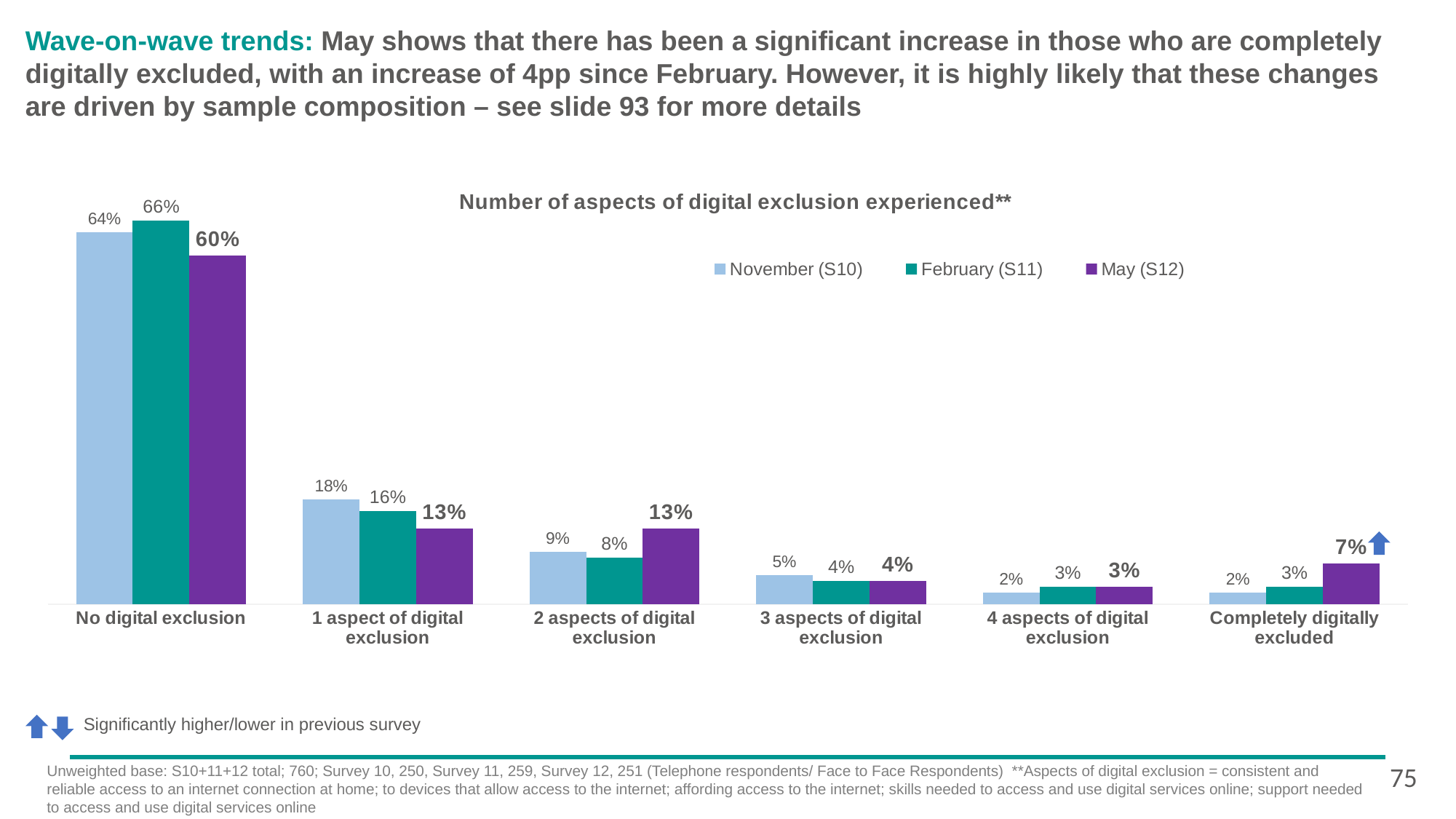
Which is larger for '2 aspects of digital exclusion': the November (S10) value or the May (S12) value? May (S12) How many series does the legend list? 3 What is the difference between the February (S11) and May (S12) values for 'No digital exclusion'? 6% What is the title of the chart? Number of aspects of digital exclusion experienced** What is the November (S10) value for '1 aspect of digital exclusion'? 18% What is the February (S11) value for 'Completely digitally excluded'? 3% What is the difference between the May (S12) and February (S11) values for 'Completely digitally excluded'? 4% Which category has the lowest November (S10) value? 4 aspects of digital exclusion and Completely digitally excluded (both 2%) How many categories are shown on the x axis? 6 What kind of chart is shown on the slide? Bar chart Which category has the highest May (S12) value? No digital exclusion What is the May (S12) value for 'No digital exclusion'? 60%